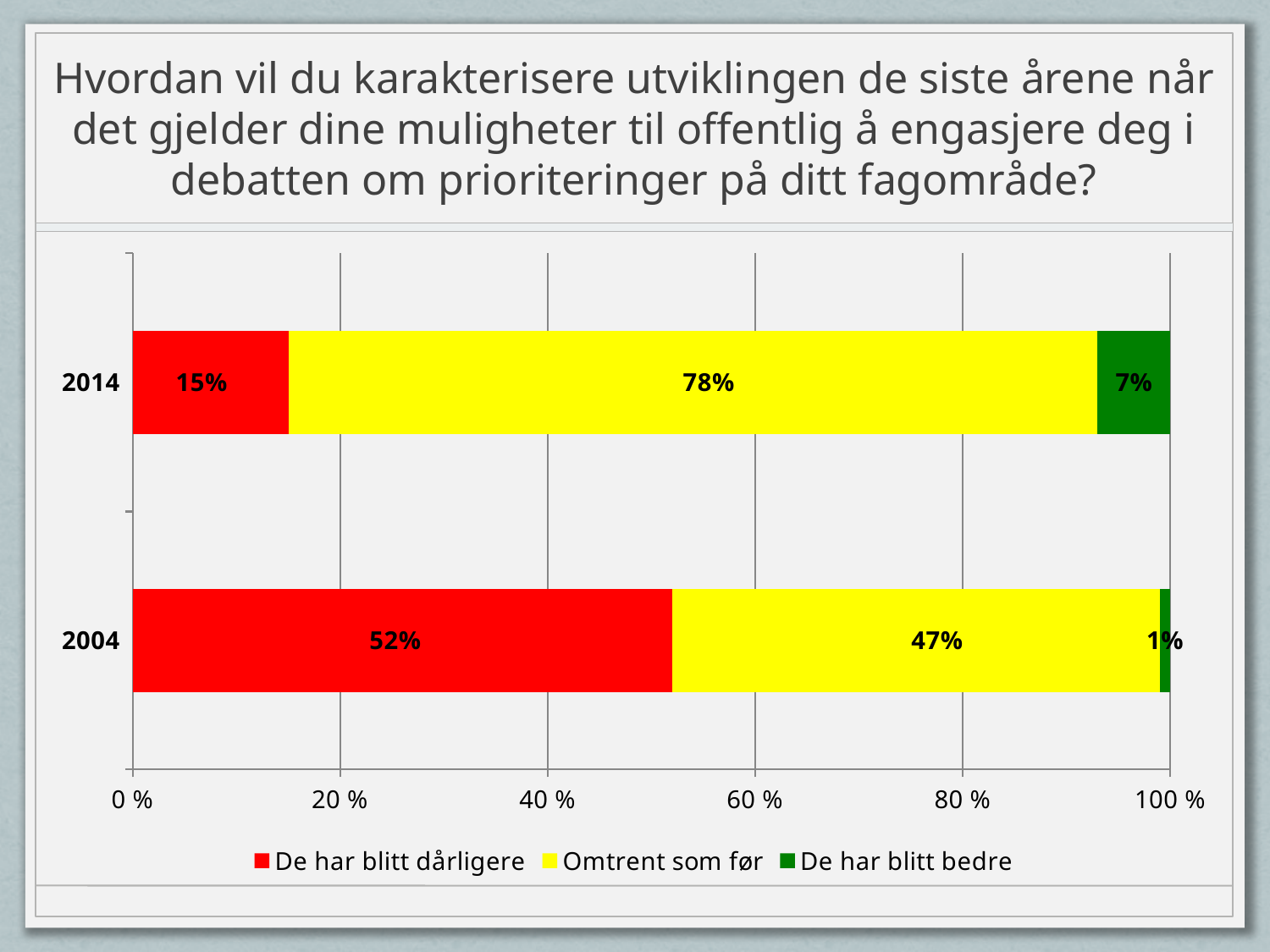
What percentage of respondents in 2014 answered "De har blitt dårligere"? 15% How many series does the legend list? 3 Which colour represents "De har blitt bedre" in the chart? Green What percentage of respondents in 2004 answered "De har blitt dårligere"? 52% How many years (categories) are shown on the chart? 2 What is the difference between the "Omtrent som før" share in 2014 and in 2004? 31% What percentage of respondents in 2004 answered "Omtrent som før"? 47% What percentage of respondents in 2014 answered "De har blitt bedre"? 7% What kind of chart is shown on the slide? Stacked bar chart What is the difference between the "De har blitt dårligere" share in 2004 and in 2014? 37% Which year has the higher share of "De har blitt dårligere" responses, 2004 or 2014? 2004 What is the total of the stacked bar for 2014? 100%